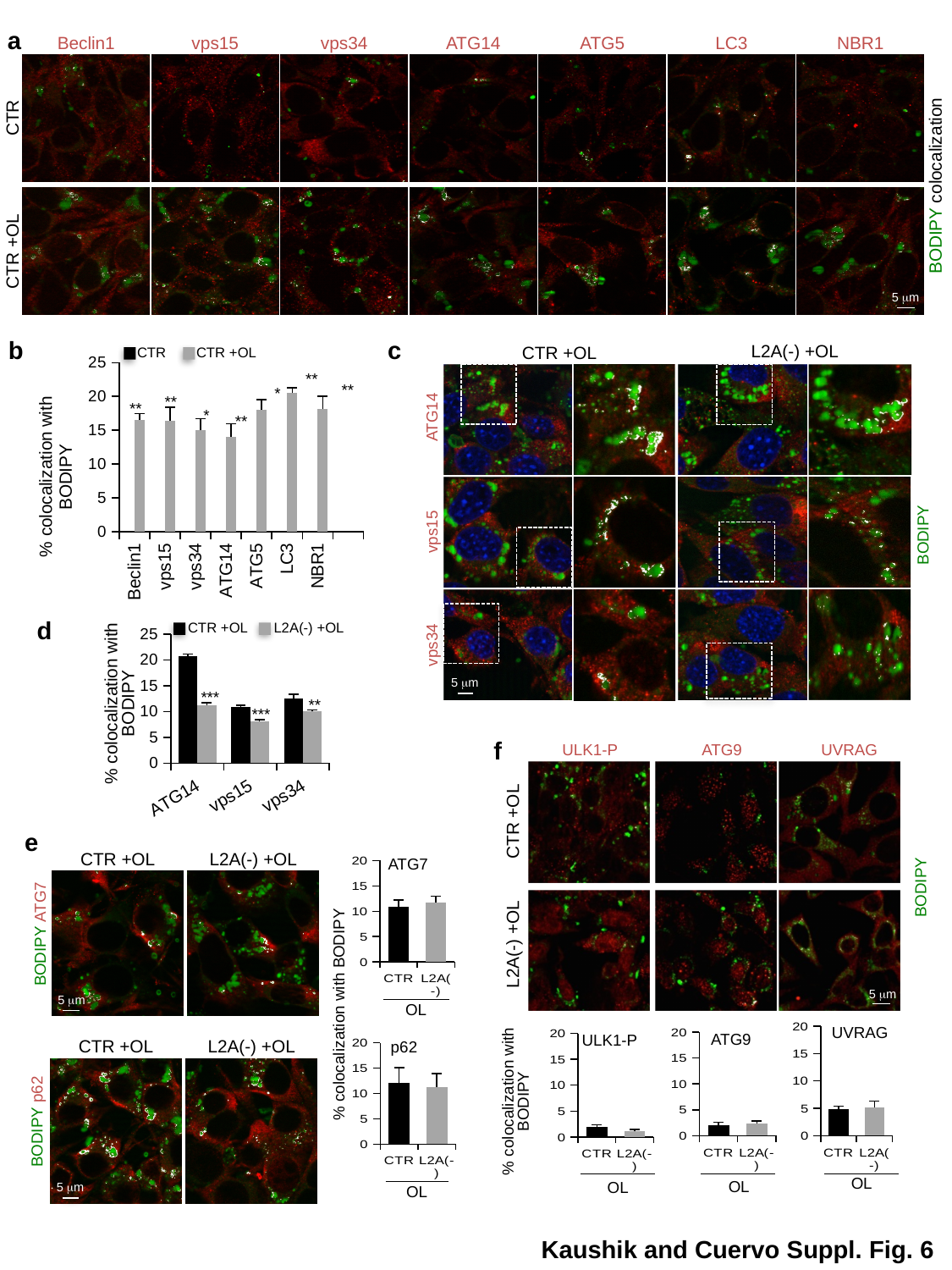
In the UVRAG chart in panel f, is the CTR value greater or less than 10? less In the bar chart in panel d, for ATG14, which series has the larger value, CTR +OL or L2A(-) +OL? CTR +OL In the bar chart in panel d, is the CTR +OL value for ATG14 greater or less than 15? greater In the bar chart in panel b, which category has the highest CTR +OL value? LC3 In the bar chart in panel b, what is the y-axis label? % colocalization with BODIPY In the bar chart in panel b, how many series does the legend list? 2 In the bar chart in panel d, how many categories are shown on the x axis? 3 In the bar chart in panel d, is the L2A(-) +OL value for vps15 greater or less than 10? less In the bar chart in panel b, how many categories are shown on the x axis? 7 In the bar chart in panel d, which series does the legend list besides CTR +OL? L2A(-) +OL In the bar chart in panel d, which category has the highest CTR +OL value? ATG14